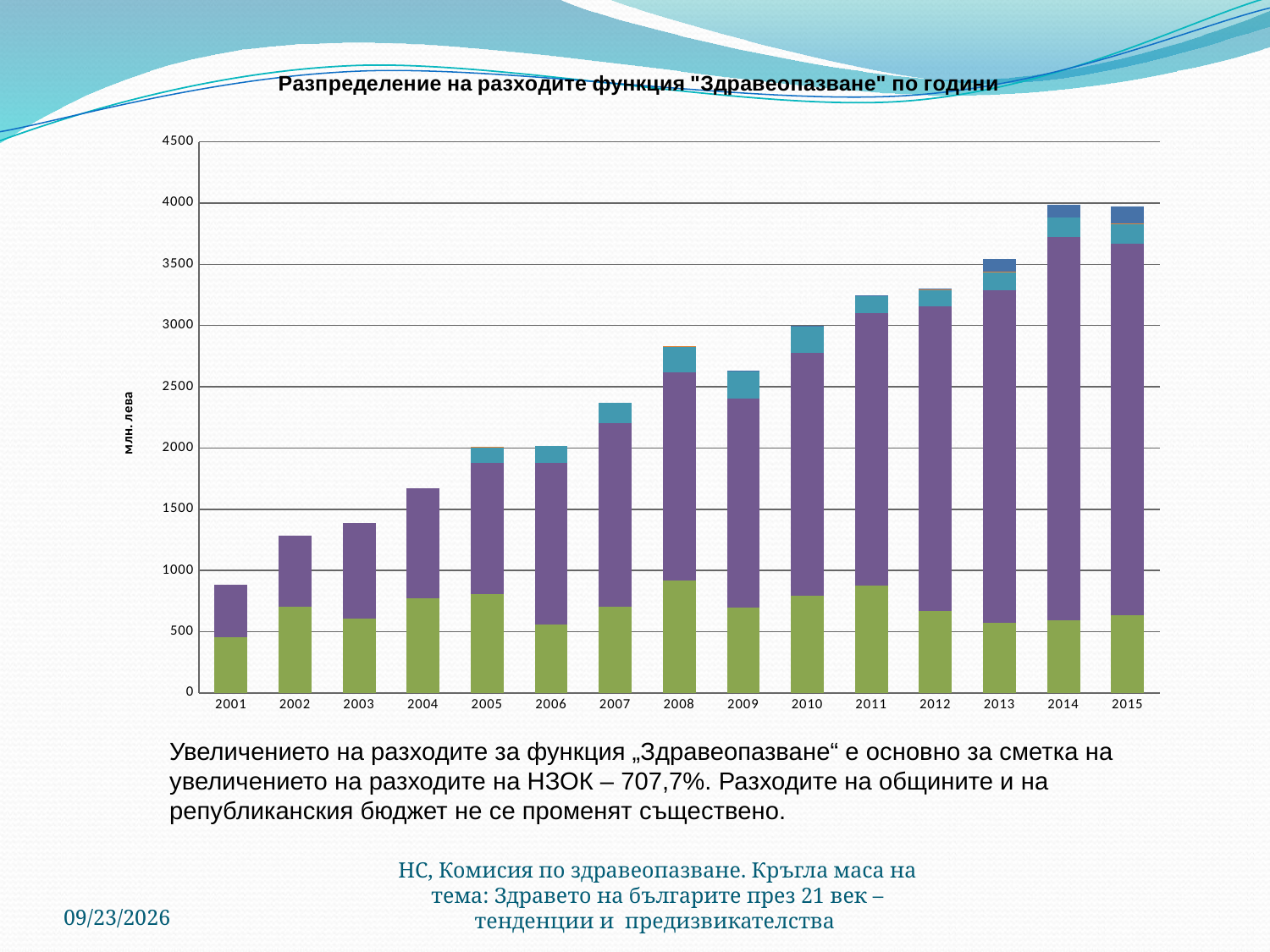
Is the total value for 2001 greater or less than 1000? less What is the label on the vertical axis of the chart? млн. лева Which year has the lowest total bar? 2001 Is the total value for 2011 greater or less than 3000? greater Do the total bar heights generally rise or fall from 2001 to 2015? rise Is the total value for 2008 greater or less than 2500? greater How many years are shown on the x axis of the chart? 15 Which year has the larger total bar, 2008 or 2009? 2008 What is the title of the chart? Разпределение на разходите функция "Здравеопазване" по години Which year has the larger total bar, 2003 or 2007? 2007 What kind of chart is shown on the slide? stacked bar chart